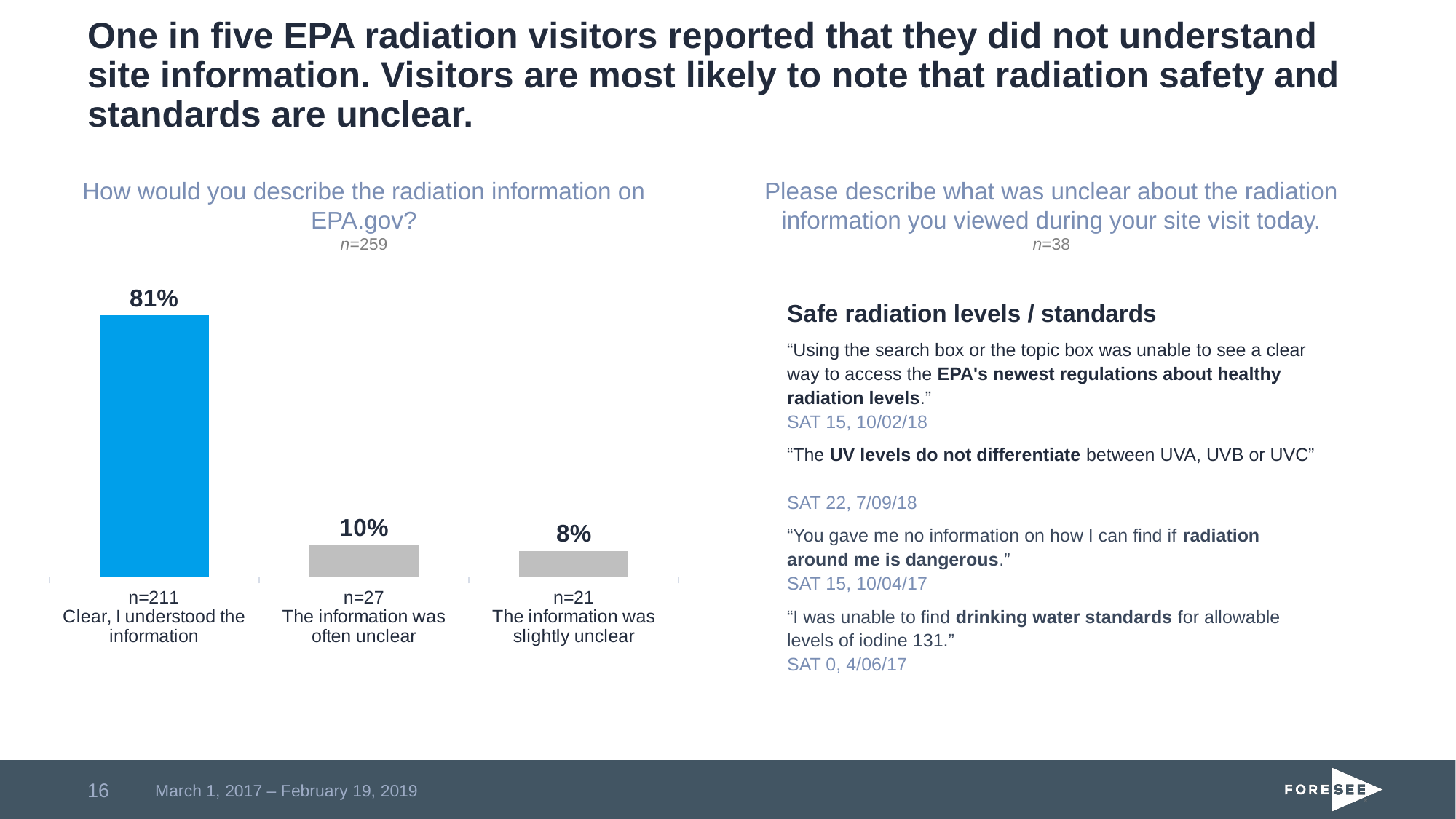
What percentage of visitors said "The information was often unclear"? 10% What is the n value for the "The information was often unclear" category? n=27 What is the total sample size (n) for the question "How would you describe the radiation information on EPA.gov?" n=259 Which response category has the highest percentage? Clear, I understood the information How many response categories are shown in the bar chart? 3 What is the difference in percentage points between "Clear, I understood the information" and "The information was often unclear"? 71 What percentage of visitors said "Clear, I understood the information"? 81% What percentage of visitors said "The information was slightly unclear"? 8% Which bar in the chart is coloured blue rather than grey? Clear, I understood the information Which is larger: the percentage for "The information was often unclear" or for "The information was slightly unclear"? The information was often unclear What type of chart is used to show how visitors describe the radiation information on EPA.gov? Bar chart Which response category has the lowest percentage? The information was slightly unclear